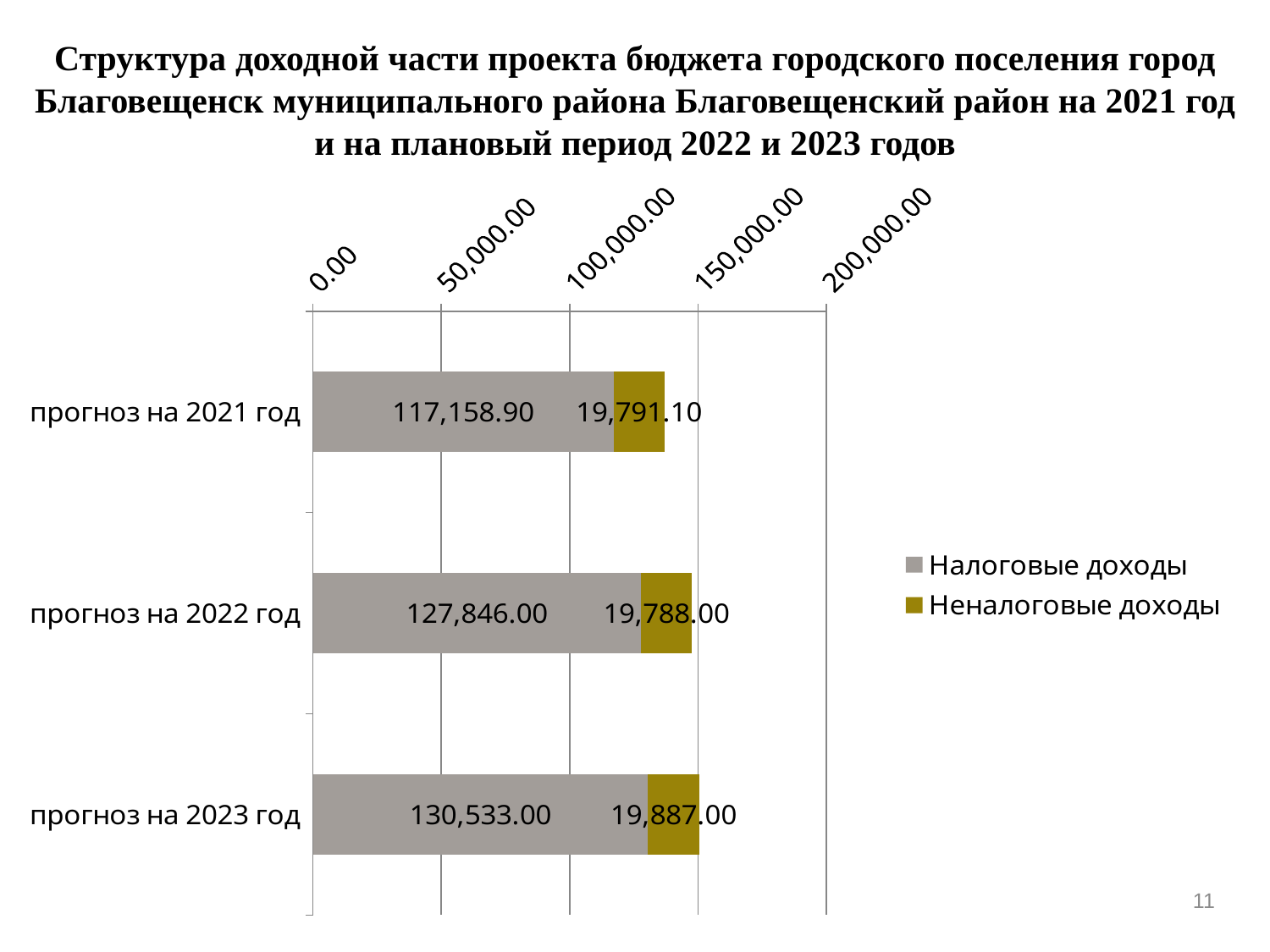
What is the total of the stacked bar for прогноз на 2022 год? 147,634.00 How many forecast years (categories) are shown in the chart? 3 How many series does the legend list? 2 Is the total of the stacked bar for прогноз на 2021 год greater or less than 150,000.00? less What is the value of Налоговые доходы for прогноз на 2021 год? 117,158.90 What kind of chart is shown on the slide? Stacked bar chart What is the value of Неналоговые доходы for прогноз на 2022 год? 19,788.00 Which is larger: Налоговые доходы for прогноз на 2022 год or for прогноз на 2021 год? прогноз на 2022 год Which forecast year has the highest value of Налоговые доходы? прогноз на 2023 год What is the value of Неналоговые доходы for прогноз на 2023 год? 19,887.00 Which forecast year has the lowest value of Налоговые доходы? прогноз на 2021 год What is the difference in Налоговые доходы between прогноз на 2023 год and прогноз на 2021 год? 13,374.10